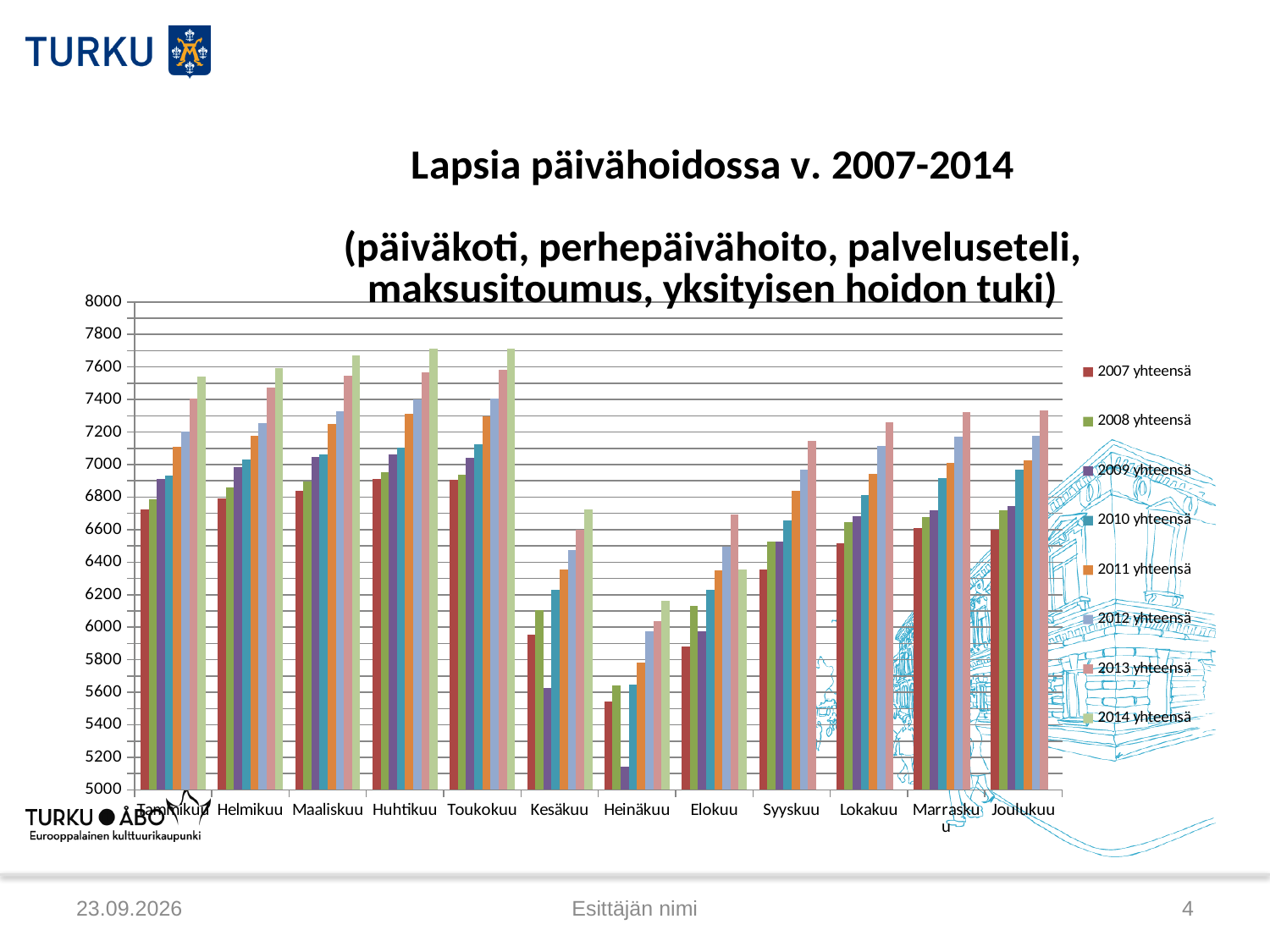
Does the 2014 yhteensä series rise or fall from Tammikuu to Huhtikuu? rise Which is larger in Syyskuu: the 2013 yhteensä value or the 2007 yhteensä value? 2013 yhteensä Is the value for 2014 yhteensä in Tammikuu greater or less than 7400? greater What kind of chart is shown on the slide? Bar chart How many month categories are shown on the x axis? 12 Is the value for 2007 yhteensä in Kesäkuu greater or less than 6200? less In which month is the 2014 yhteensä value lowest? Heinäkuu What is the first entry listed in the chart legend? 2007 yhteensä Is the value for 2007 yhteensä in Lokakuu greater or less than 6600? less How many series does the legend list? 8